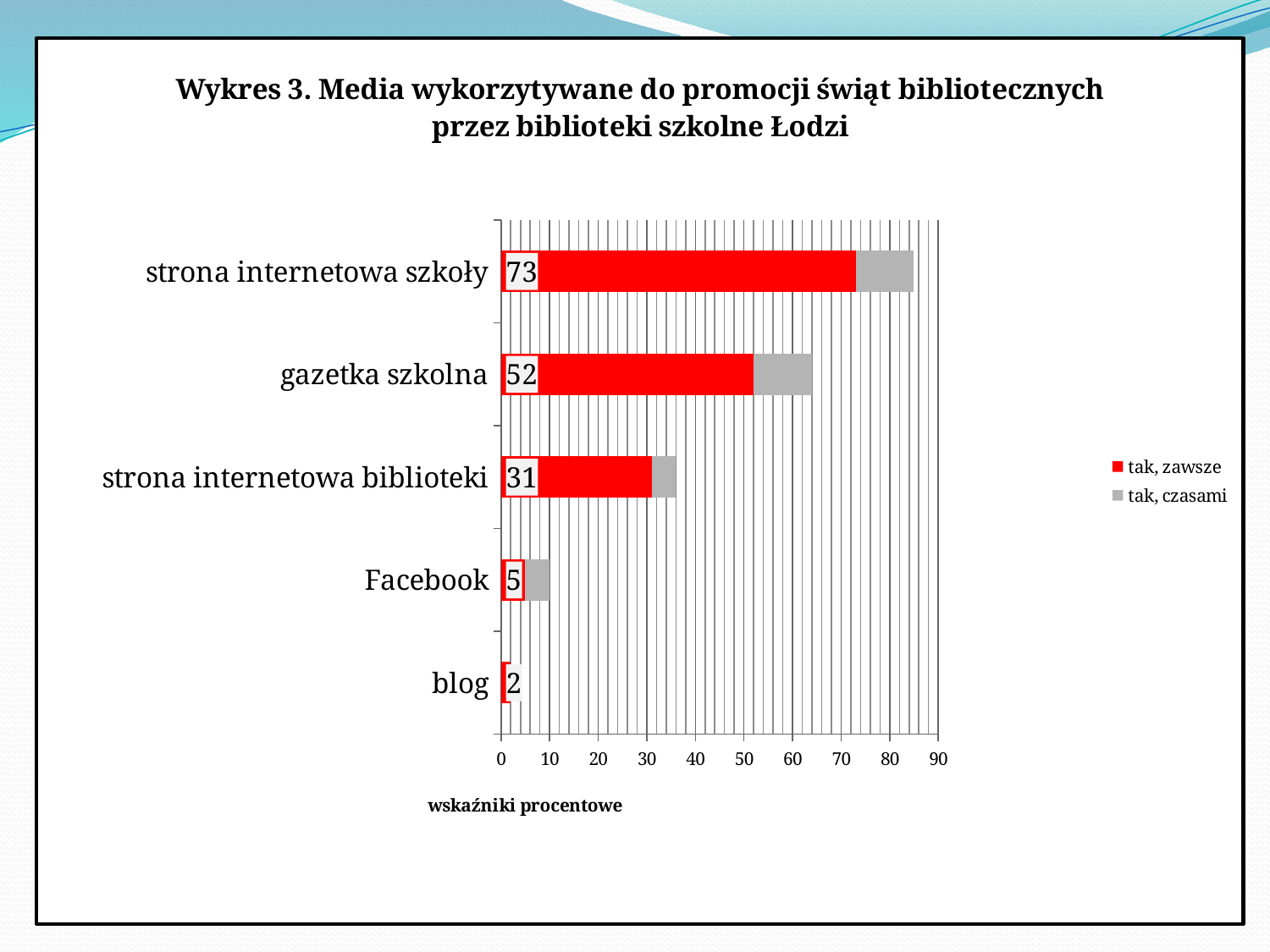
What is the value of "tak, zawsze" for strona internetowa szkoły? 73 What is the difference between the "tak, zawsze" values for strona internetowa szkoły and gazetka szkolna? 21 Which category has the highest "tak, zawsze" value? strona internetowa szkoły What is the value of "tak, zawsze" for Facebook? 5 What kind of chart is shown on the slide? bar chart What is the value of "tak, zawsze" for strona internetowa biblioteki? 31 How many series does the legend list? 2 Which has a larger "tak, zawsze" value, gazetka szkolna or strona internetowa biblioteki? gazetka szkolna Is the total length of the bar for strona internetowa szkoły greater or less than 80? greater What is the value of "tak, zawsze" for gazetka szkolna? 52 How many categories are shown on the chart? 5 Which category has the lowest "tak, zawsze" value? blog